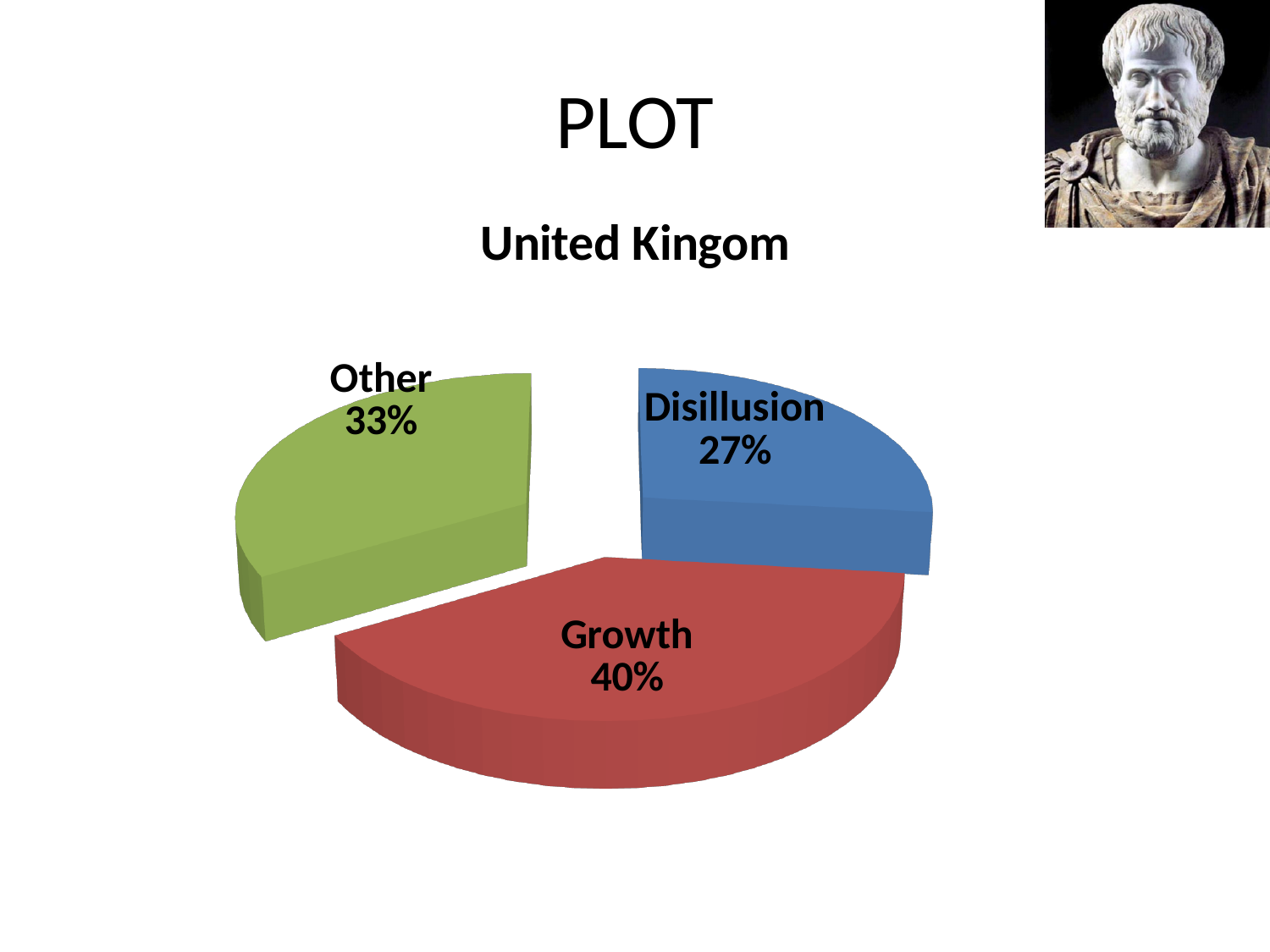
What is the difference between the Growth and Disillusion shares? 13% What is the title of the chart? United Kingom Which slice is the largest? Growth What colour is the Growth slice? red How many slices does the pie chart have? 3 Which is larger, the Other slice or the Disillusion slice? Other What is the difference between the Other and Disillusion shares? 6% What share of the pie does Growth represent? 40% Which slice is the smallest? Disillusion What share of the pie does Disillusion represent? 27% What type of chart is shown on the slide? pie chart What share of the pie does Other represent? 33%